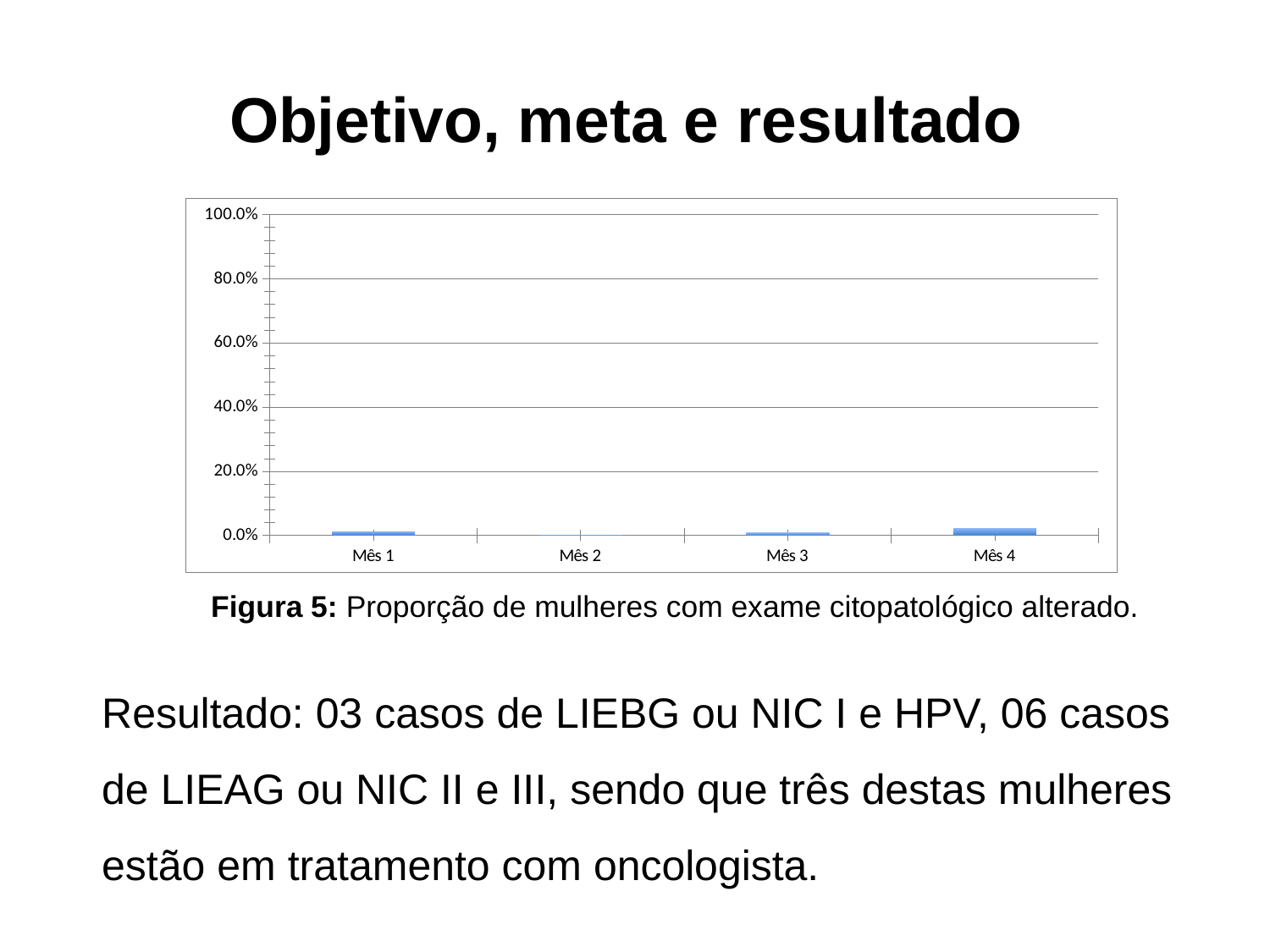
Is the value for Mês 1 greater or less than 20.0%? less Is the value for Mês 3 greater or less than 40.0%? less Which month has the lowest bar in the chart? Mês 2 According to the figure caption, what does the chart show? Proporção de mulheres com exame citopatológico alterado What kind of chart is shown on the slide? bar chart Is the value for Mês 4 greater or less than 20.0%? less What is the highest value shown on the y axis of the chart? 100.0% How many categories (months) are plotted on the x axis of the chart? 4 Which month has the highest bar in the chart? Mês 4 Which is larger, the value for Mês 4 or the value for Mês 2? Mês 4